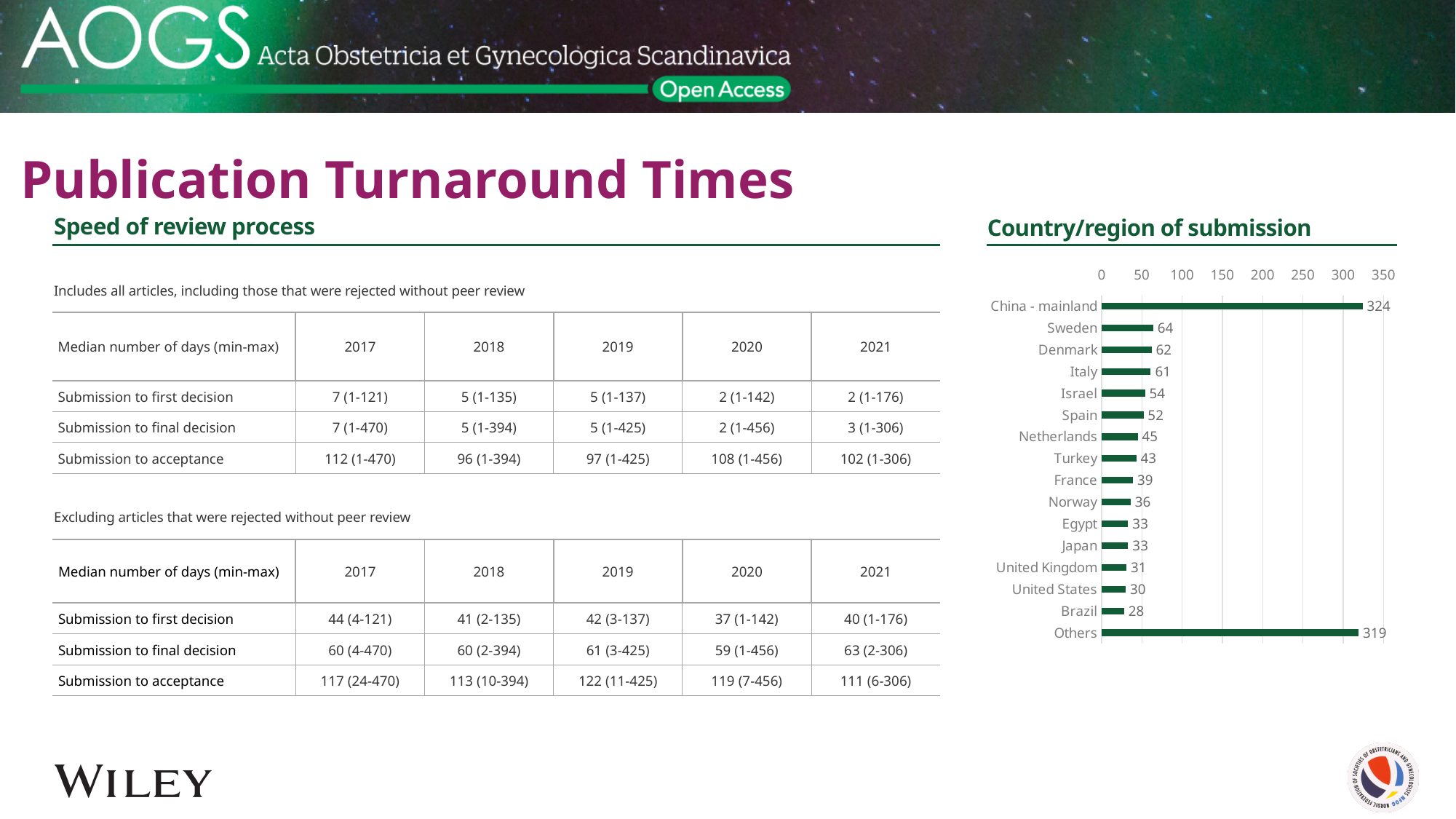
What kind of chart is the Country/region of submission chart? Bar chart How many categories are shown in the Country/region of submission chart? 16 In the Country/region of submission chart, which is larger, the value for Israel or the value for Spain? Israel In the Country/region of submission chart, what is the value for Sweden? 64 In the Country/region of submission chart, what is the difference between the values for China - mainland and Others? 5 In the Country/region of submission chart, what is the difference between the values for Sweden and Denmark? 2 In the Country/region of submission chart, which named country has the highest value? China - mainland In the Country/region of submission chart, which category has the lowest value? Brazil In the Country/region of submission chart, what is the value for China - mainland? 324 In the Country/region of submission chart, what is the value for Brazil? 28 In the Country/region of submission chart, is the value for Italy greater or less than 50? greater In the Country/region of submission chart, what is the value for Netherlands? 45